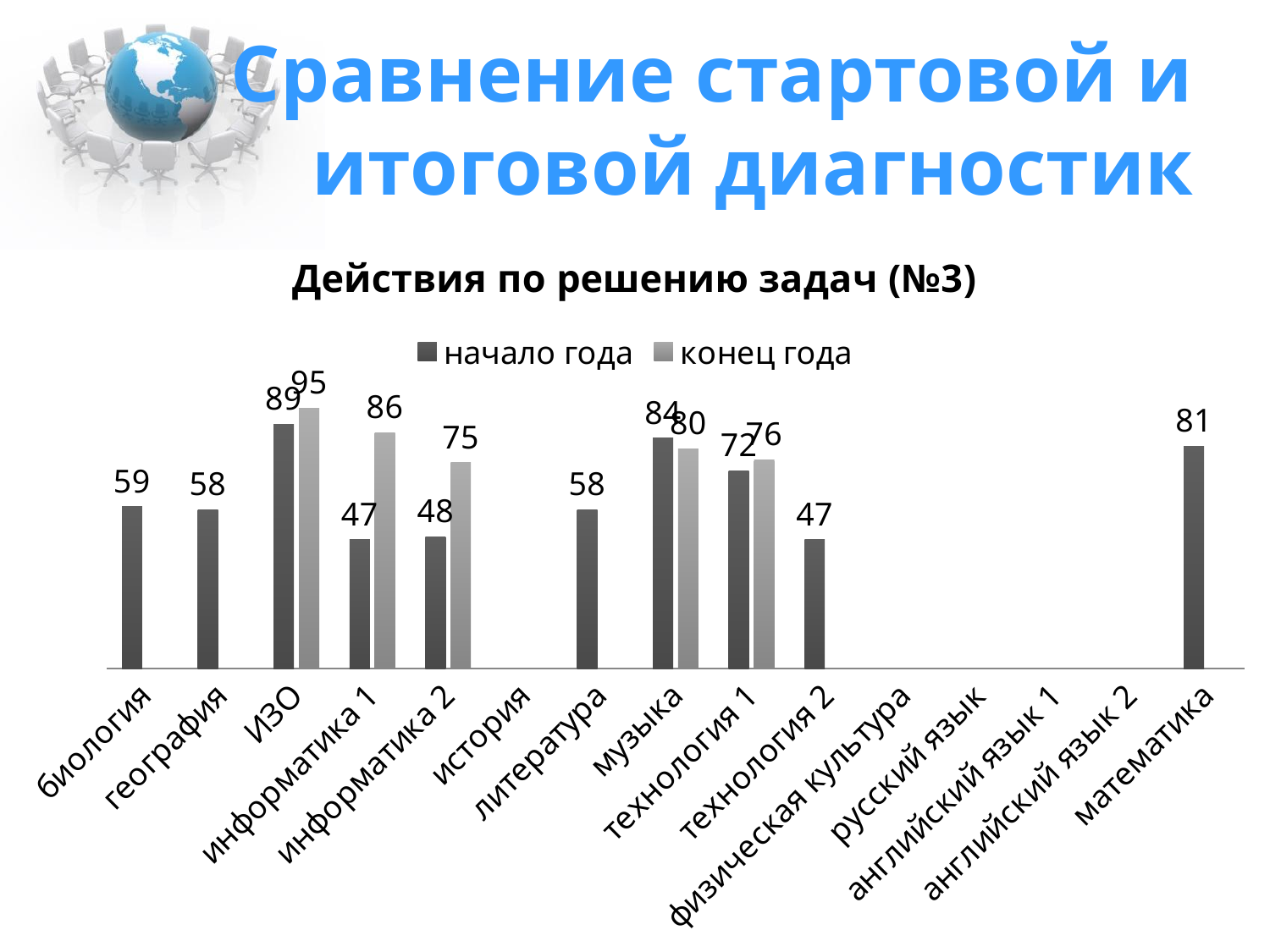
Which category has the highest value in the конец года series? ИЗО What is the difference between the конец года and начало года values for информатика 1? 39 What is the value for математика in the начало года series? 81 What type of chart is shown on the slide? bar chart Which category has the highest value in the начало года series? ИЗО How many categories are shown on the x axis? 15 What is the value for информатика 1 in the начало года series? 47 What is the value for ИЗО in the конец года series? 95 How many series does the legend list? 2 What is the difference between the конец года and начало года values for технология 1? 4 What is the value for музыка in the конец года series? 80 For музыка, which is larger: the начало года value or the конец года value? начало года